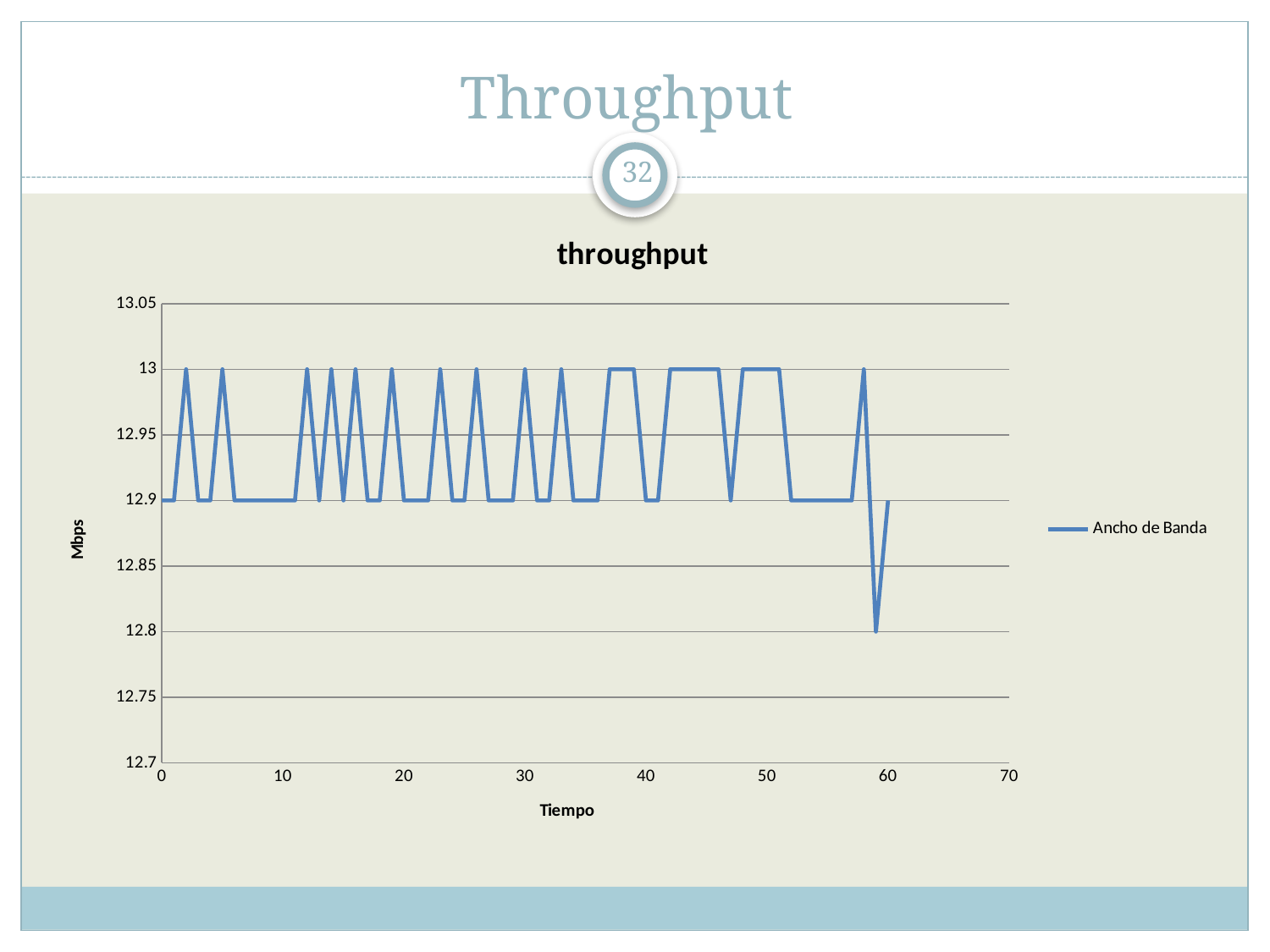
What is the difference between the highest and lowest values of the Ancho de Banda line? 0.2 How many series does the legend list? 1 Is the highest value of the Ancho de Banda line greater or less than 12.95? greater What is the highest value reached by the Ancho de Banda line? 13 Is the lowest value of the Ancho de Banda line greater or less than 12.85? less Which is larger, the value of Ancho de Banda at Tiempo 0 or the lowest value on the line near Tiempo 59? the value at Tiempo 0 What is the name of the series shown in the legend? Ancho de Banda What is the value of Ancho de Banda at Tiempo 0? 12.9 What kind of chart is shown on the slide? line chart What is the lowest value reached by the Ancho de Banda line? 12.8 What is the title of the chart? throughput Is the value of Ancho de Banda at Tiempo 0 greater or less than 12.95? less